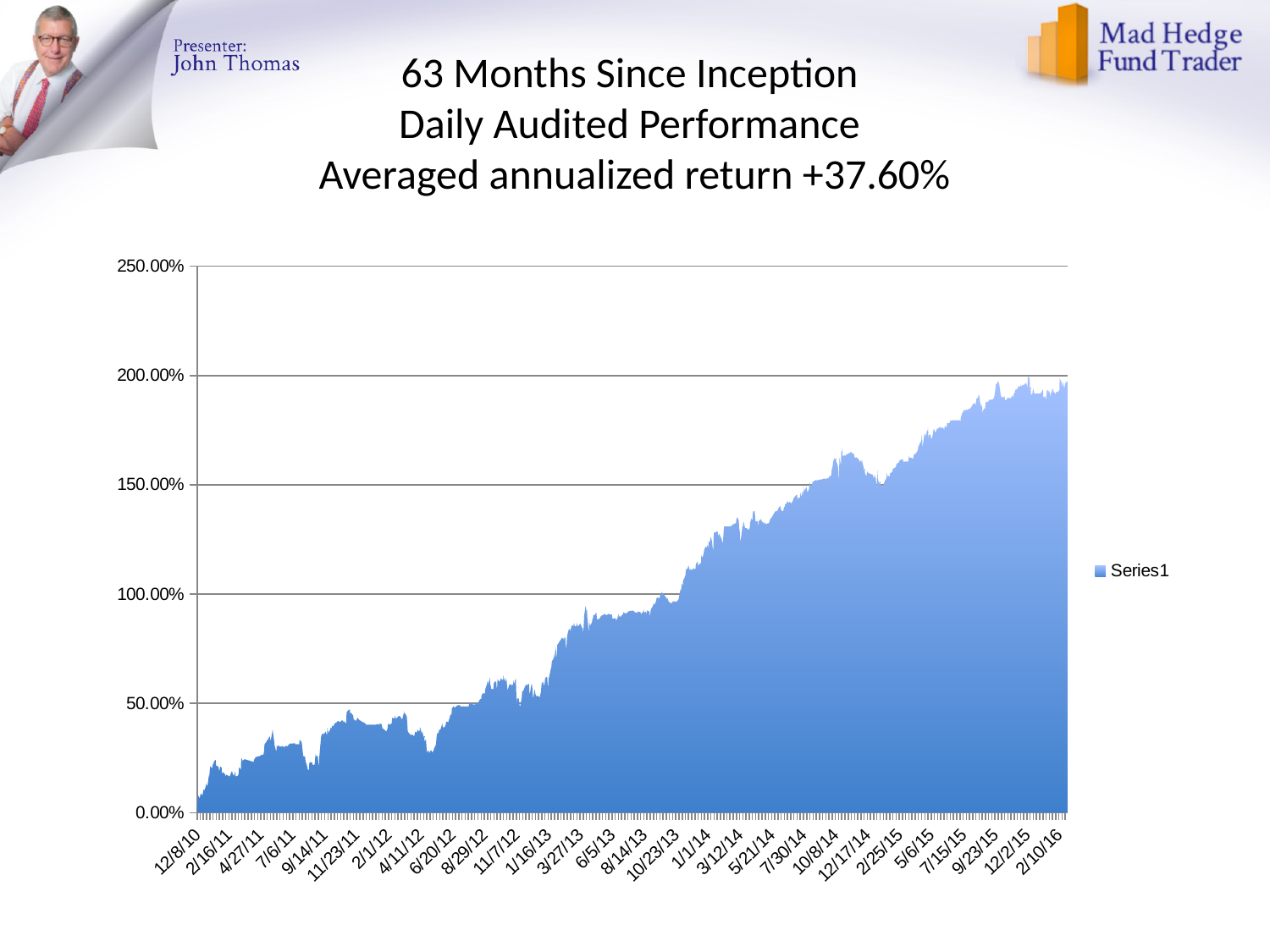
How many series does the legend list? 1 Is the value at 2/10/16 greater or less than 200%? less Is the value at 3/27/13 greater or less than 100%? less What is the highest value shown on the vertical axis? 250.00% What is the name of the series shown in the legend? Series1 Is the value at 7/15/15 greater or less than 150%? greater Do the values generally rise or fall from 12/8/10 to 2/10/16? rise What kind of chart is shown on the slide? area chart Which is larger, the value at 9/14/11 or the value at 5/21/14? 5/21/14